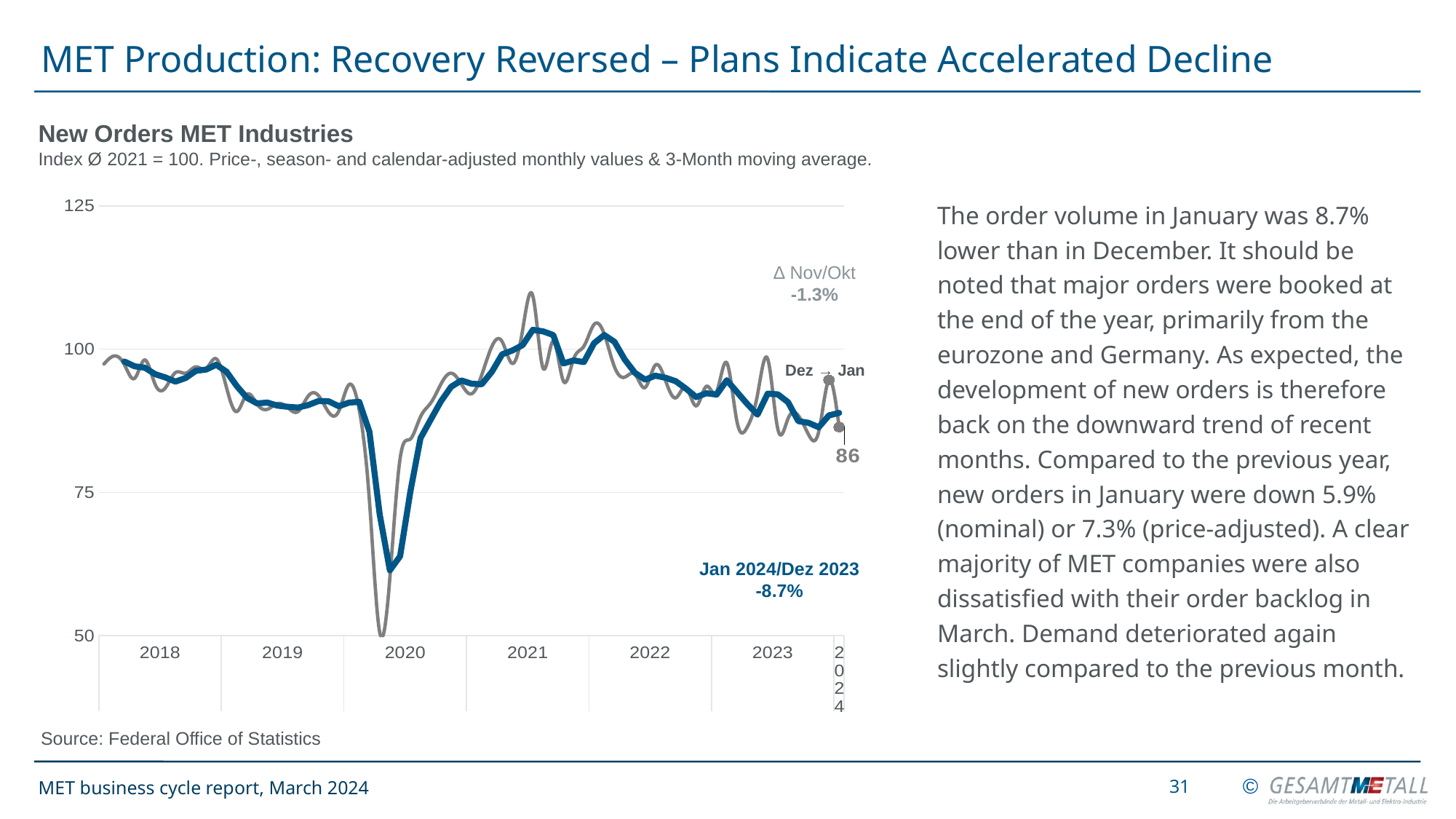
What percentage change is shown for Jan 2024 compared with Dez 2023? -8.7% What is the title of the chart? New Orders MET Industries Do the values generally rise or fall from the 2021 peak through 2023? fall What kind of chart is shown on the slide? line chart What is the labelled value of the monthly new orders index for January 2024? 86 Is the highest value of the monthly series in 2021 greater or less than 100? greater In which year does the chart reach its lowest point? 2020 How many years are labelled on the x axis? 7 What is the source given for the chart data? Federal Office of Statistics What percentage change is shown for Δ Nov/Okt? -1.3% Is the value at the start of 2018 greater or less than 75? greater Is the lowest value of the monthly series in 2020 greater or less than 75? less